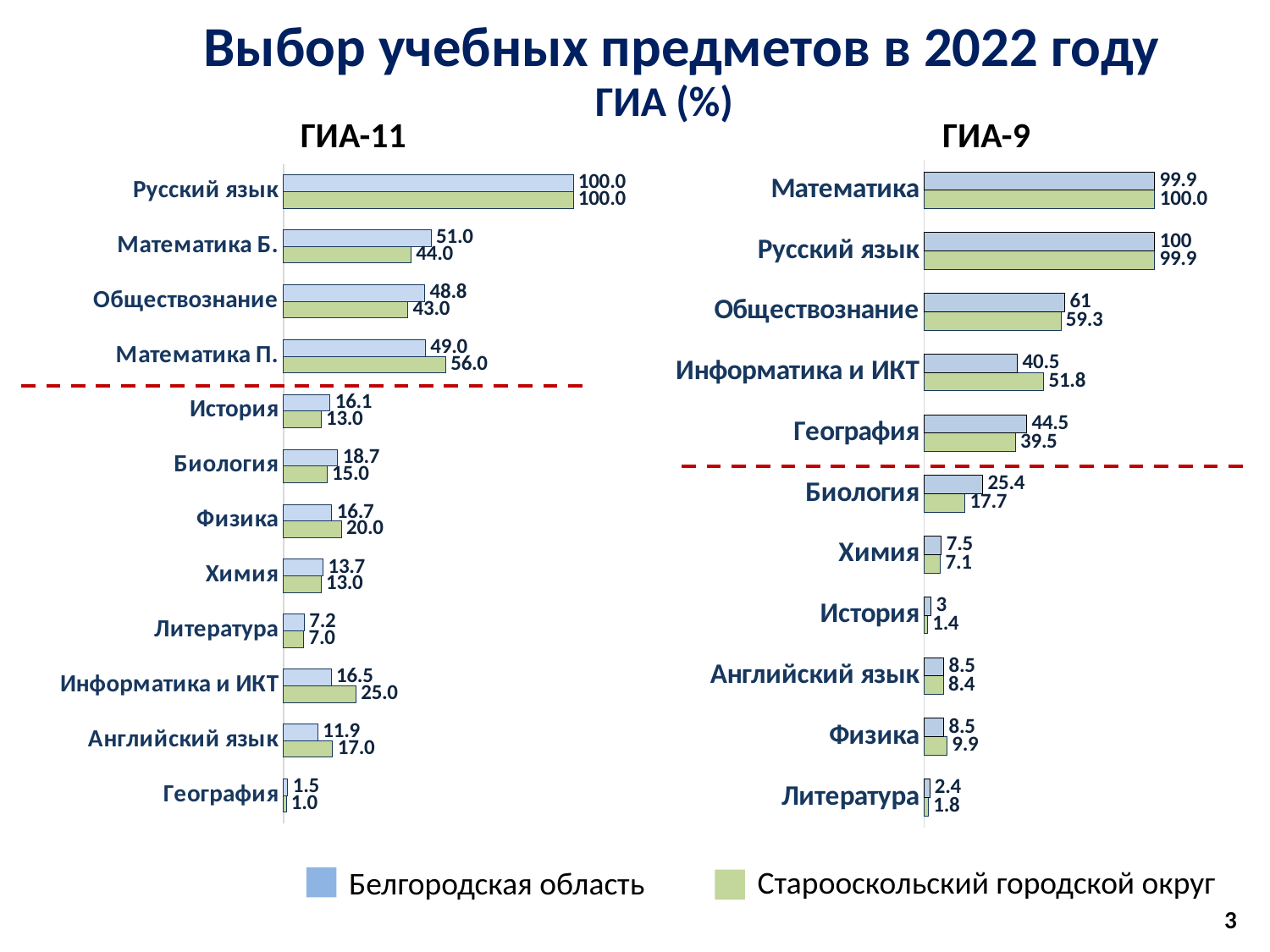
How many subjects are shown in the ГИА-9 chart? 11 How many subjects are shown in the ГИА-11 chart? 12 How many series does the legend list? 2 In the ГИА-11 chart, what is the value for Математика П. for Старооскольский городской округ? 56.0 In the ГИА-11 chart, what is the difference between the Белгородская область and Старооскольский городской округ values for Информатика и ИКТ? 8.5 In the ГИА-11 chart, which subject has the lowest value for Старооскольский городской округ? География In the ГИА-9 chart, which is larger for География: the Белгородская область value or the Старооскольский городской округ value? Белгородская область In the ГИА-11 chart, which is larger for Физика: the Белгородская область value or the Старооскольский городской округ value? Старооскольский городской округ In the ГИА-9 chart, what is the difference between the Белгородская область and Старооскольский городской округ values for Биология? 7.7 In the ГИА-9 chart, which subject has the lowest value for Белгородская область? Литература What type of chart is the ГИА-9 chart? Bar chart In the ГИА-9 chart, what is the value for Информатика и ИКТ for Белгородская область? 40.5